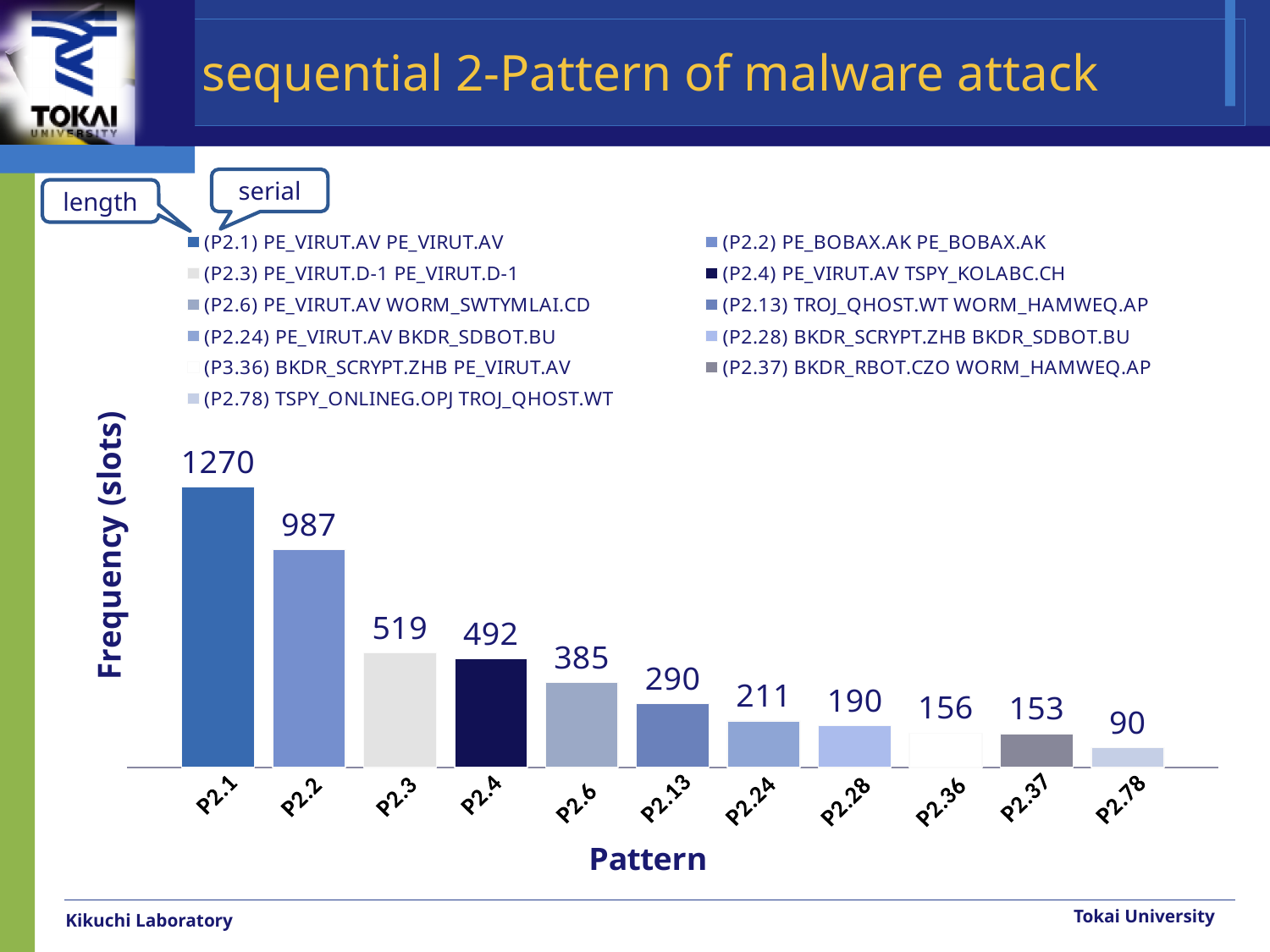
What is the frequency value for pattern P2.1? 1270 Which pattern has the highest frequency? P2.1 How many patterns are plotted on the x axis? 11 What is the difference in frequency between P2.3 and P2.4? 27 What is the frequency value for pattern P2.13? 290 Which pattern has the lowest frequency? P2.78 What is the frequency value for pattern P2.78? 90 What is the label of the y axis? Frequency (slots) What is the difference in frequency between P2.1 and P2.2? 283 What type of chart is shown on the slide? Bar chart Which has a higher frequency, P2.6 or P2.24? P2.6 Do the frequency values rise or fall from left to right along the x axis? Fall